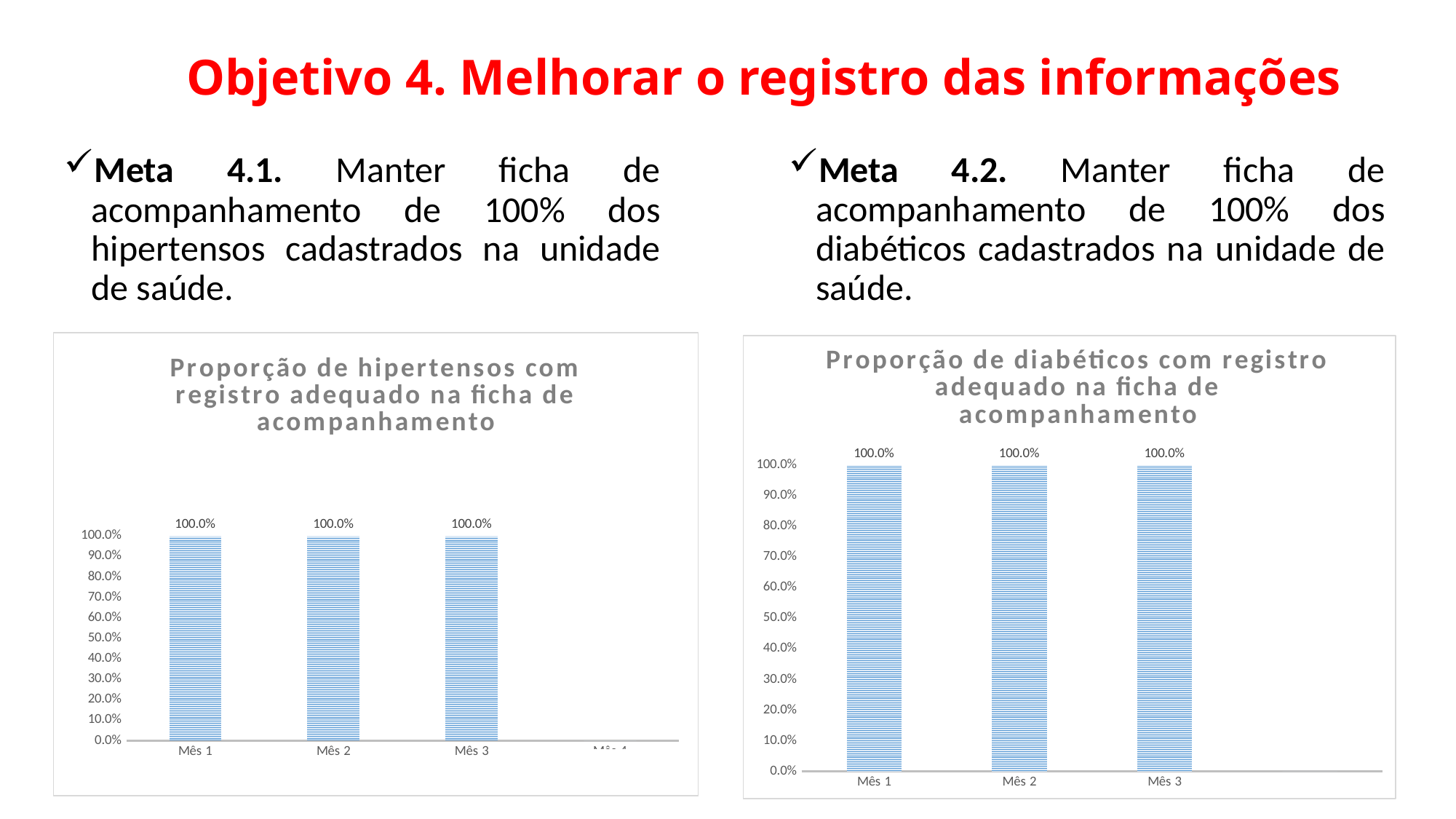
In the right chart (Proporção de diabéticos com registro adequado na ficha de acompanhamento), what is the value for Mês 3? 100.0% In the right chart (Proporção de diabéticos com registro adequado na ficha de acompanhamento), how many months are plotted? 3 What is the title of the right chart? Proporção de diabéticos com registro adequado na ficha de acompanhamento What kind of chart is the left chart (Proporção de hipertensos com registro adequado na ficha de acompanhamento)? Bar chart In the left chart (Proporção de hipertensos com registro adequado na ficha de acompanhamento), is the value for Mês 2 greater or less than 50.0%? greater What is the title of the left chart? Proporção de hipertensos com registro adequado na ficha de acompanhamento In the right chart (Proporção de diabéticos com registro adequado na ficha de acompanhamento), what is the value for Mês 2? 100.0% In the right chart (Proporção de diabéticos com registro adequado na ficha de acompanhamento), what is the difference between the values for Mês 1 and Mês 3? 0.0% What kind of chart is the right chart (Proporção de diabéticos com registro adequado na ficha de acompanhamento)? Bar chart In the right chart (Proporção de diabéticos com registro adequado na ficha de acompanhamento), do the values rise, fall or stay the same from Mês 1 to Mês 3? Stay the same In the left chart (Proporção de hipertensos com registro adequado na ficha de acompanhamento), what is the value for Mês 1? 100.0% In the left chart (Proporção de hipertensos com registro adequado na ficha de acompanhamento), what is the value for Mês 3? 100.0%